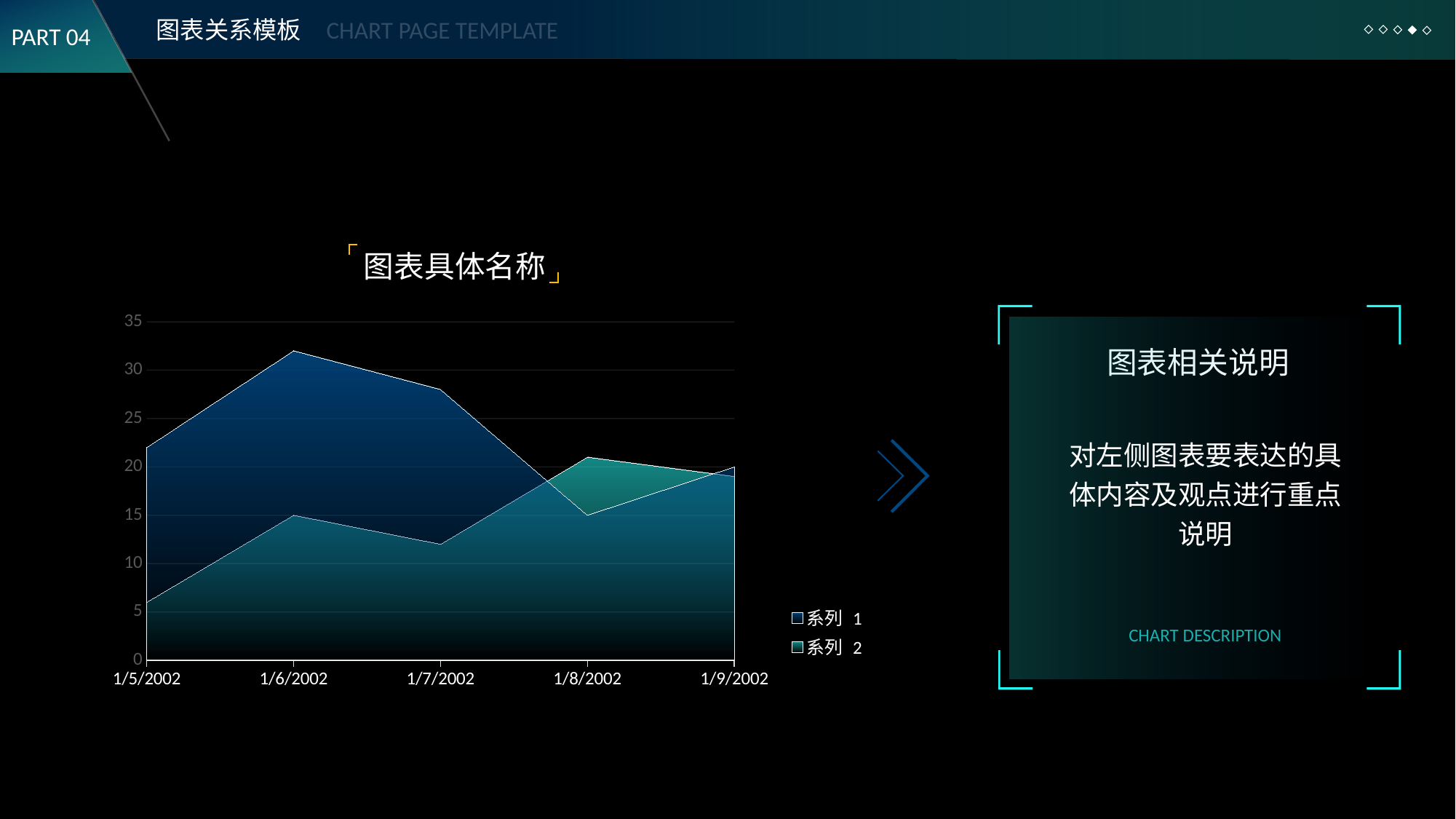
On which date does 系列 1 reach its highest value? 1/6/2002 Is the value for 系列 2 on 1/7/2002 greater or less than 10? greater Does 系列 1 rise or fall from 1/6/2002 to 1/8/2002? fall Is the value for 系列 2 on 1/5/2002 greater or less than 10? less What is the title shown above the chart? 图表具体名称 How many series does the chart legend list? 2 What kind of chart is shown on the slide? Area chart On which date does 系列 2 have its lowest value? 1/5/2002 How many dates are shown on the x axis of the chart? 5 Is the value for 系列 1 on 1/7/2002 greater or less than 25? greater On 1/6/2002, which series has the larger value, 系列 1 or 系列 2? 系列 1